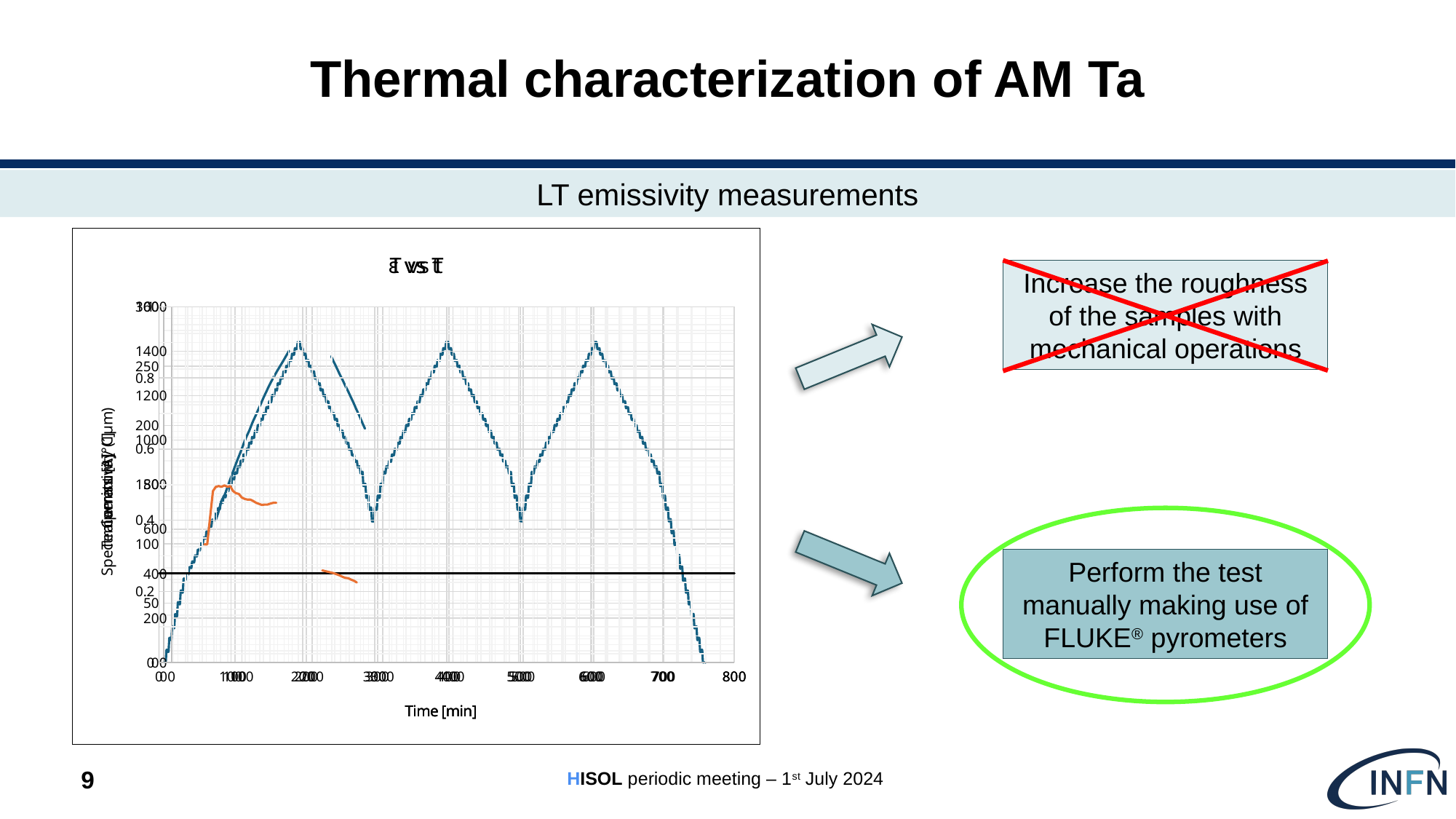
Is the time of the third peak of the blue line greater or less than 500 min? greater How many peaks does the blue line reach across the chart? 3 What kind of chart is shown on the slide? line chart Is the time of the first peak of the blue line greater or less than 300 min? less Does the blue line rise or fall between the third peak and the end of the chart? fall What is the largest tick value shown on the x axis of the chart? 800 What is the label of the x axis of the chart? Time [min] Is the time at which the blue line ends greater or less than 700 min? greater